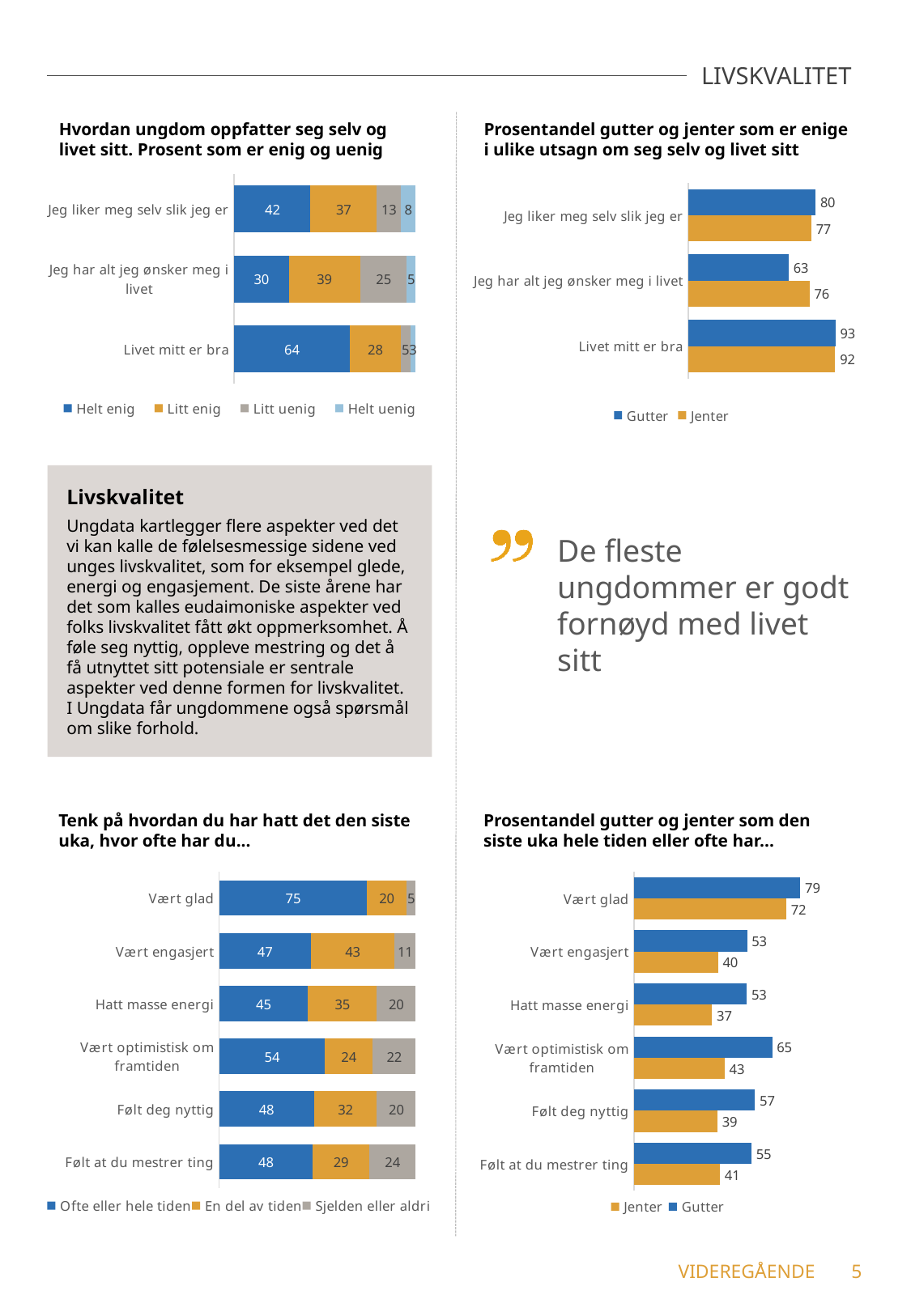
In the bottom-right chart 'Prosentandel gutter og jenter som den siste uka hele tiden eller ofte har…', which is larger for 'Følt deg nyttig': Gutter or Jenter? Gutter In the top-left chart 'Hvordan ungdom oppfatter seg selv og livet sitt', what is the 'Litt uenig' value for 'Jeg har alt jeg ønsker meg i livet'? 25 In the bottom-right chart 'Prosentandel gutter og jenter som den siste uka hele tiden eller ofte har…', what is the value for Jenter on 'Hatt masse energi'? 37 In the top-right chart 'Prosentandel gutter og jenter som er enige i ulike utsagn om seg selv og livet sitt', what is the difference between Gutter and Jenter for 'Jeg har alt jeg ønsker meg i livet'? 13 In the bottom-left chart 'Tenk på hvordan du har hatt det den siste uka, hvor ofte har du…', which category has the highest 'Ofte eller hele tiden' value? Vært glad What kind of chart is the bottom-right chart 'Prosentandel gutter og jenter som den siste uka hele tiden eller ofte har…'? Bar chart In the bottom-left chart 'Tenk på hvordan du har hatt det den siste uka, hvor ofte har du…', how many categories are shown? 6 In the bottom-left chart 'Tenk på hvordan du har hatt det den siste uka, hvor ofte har du…', what is the 'Ofte eller hele tiden' value for 'Vært optimistisk om framtiden'? 54 In the top-left chart 'Hvordan ungdom oppfatter seg selv og livet sitt', how many series does the legend list? 4 In the top-left chart 'Hvordan ungdom oppfatter seg selv og livet sitt', what is the 'Helt enig' value for 'Livet mitt er bra'? 64 In the top-right chart 'Prosentandel gutter og jenter som er enige i ulike utsagn om seg selv og livet sitt', which statement has the highest value for Gutter? Livet mitt er bra In the top-right chart 'Prosentandel gutter og jenter som er enige i ulike utsagn om seg selv og livet sitt', what is the value for Jenter on 'Jeg har alt jeg ønsker meg i livet'? 76